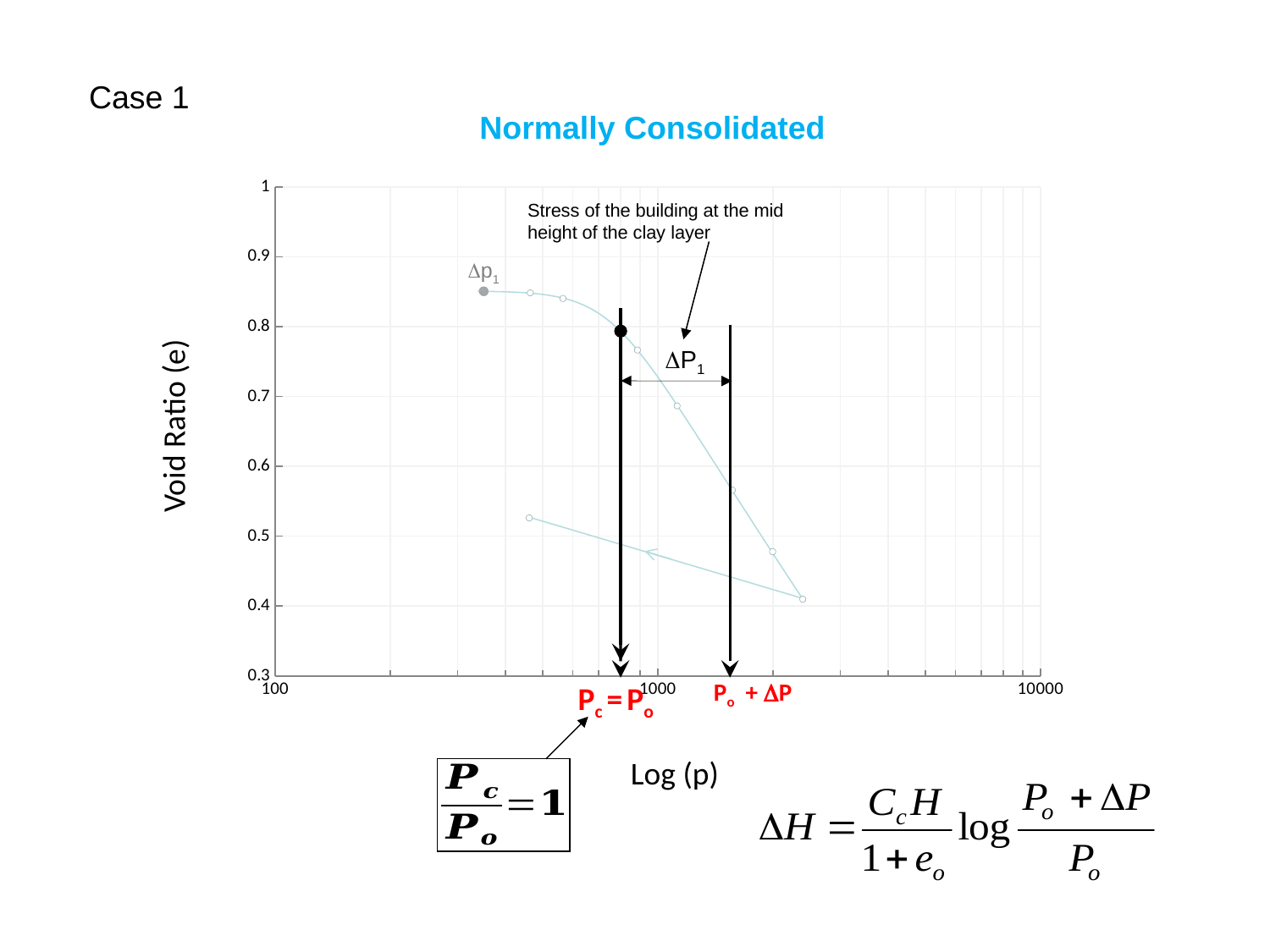
What is the lowest value shown on the vertical axis? 0.3 Is the void ratio on the curve at Po + ΔP greater or less than 0.7? less Is the void ratio of the lowest point on the curve greater or less than 0.5? less Is the void ratio of the point labelled Δp1 greater or less than 0.8? greater What kind of chart is shown on the slide? line chart What is the label of the vertical axis of the chart? Void Ratio (e) What is the highest value shown on the vertical axis? 1 Along the main curve, does the void ratio rise or fall as p increases? fall